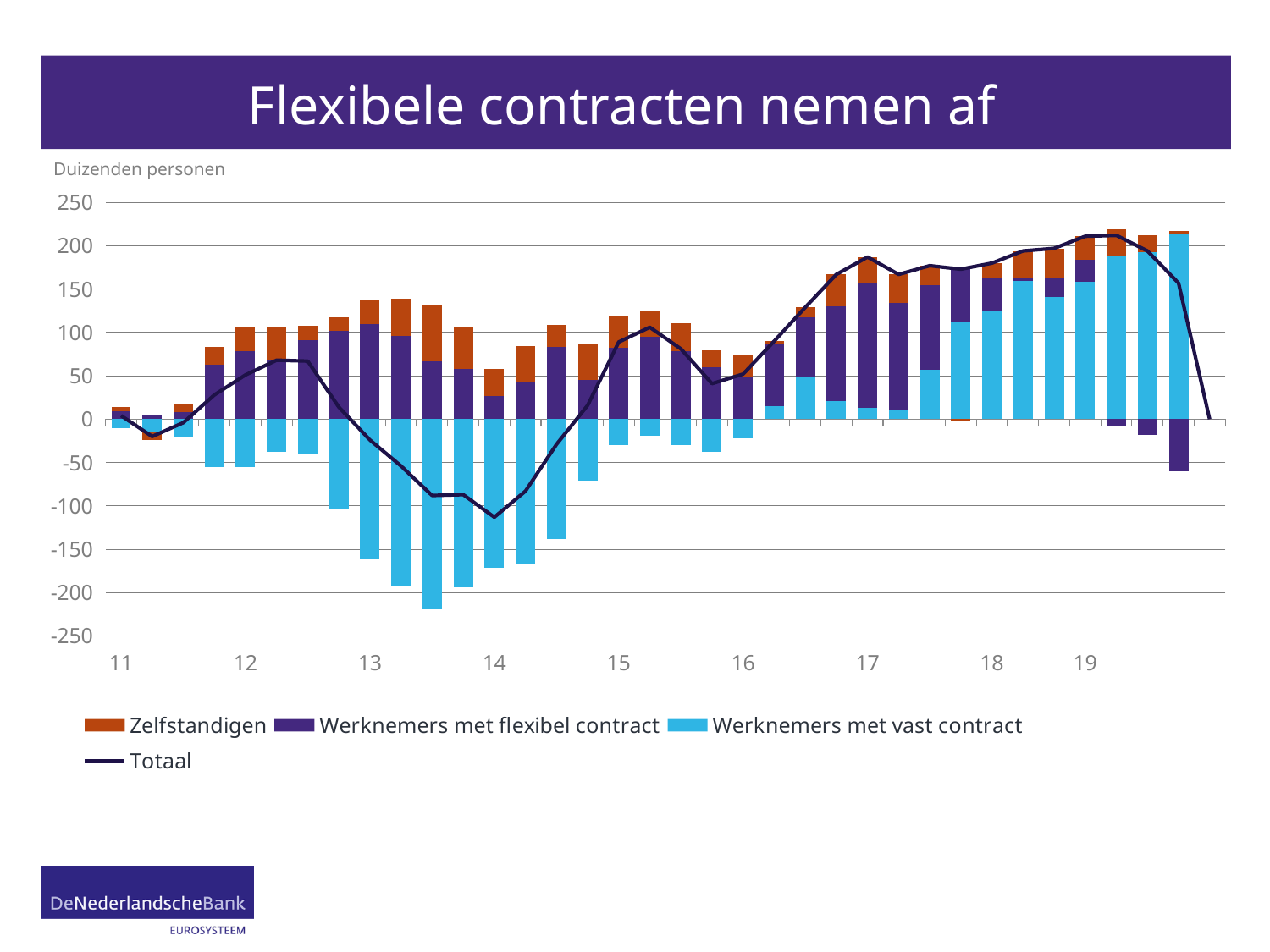
Is the value for Werknemers met vast contract in the middle of 2013 (the lowest light-blue bar) greater or less than -200? less Is the value of the Totaal line at 19 greater or less than 200? greater What unit is given above the y axis? Duizenden personen Does the Totaal line rise or fall between 16 and 19? rise What is the highest value shown on the y axis? 250 What kind of chart is shown on the slide? A stacked bar chart with a line Which series is drawn as a line rather than as bars? Totaal Is the value of the Totaal line at 17 greater or less than 150? greater Does the Totaal line rise or fall between 12.5 and 14? fall How many series does the legend list? 4